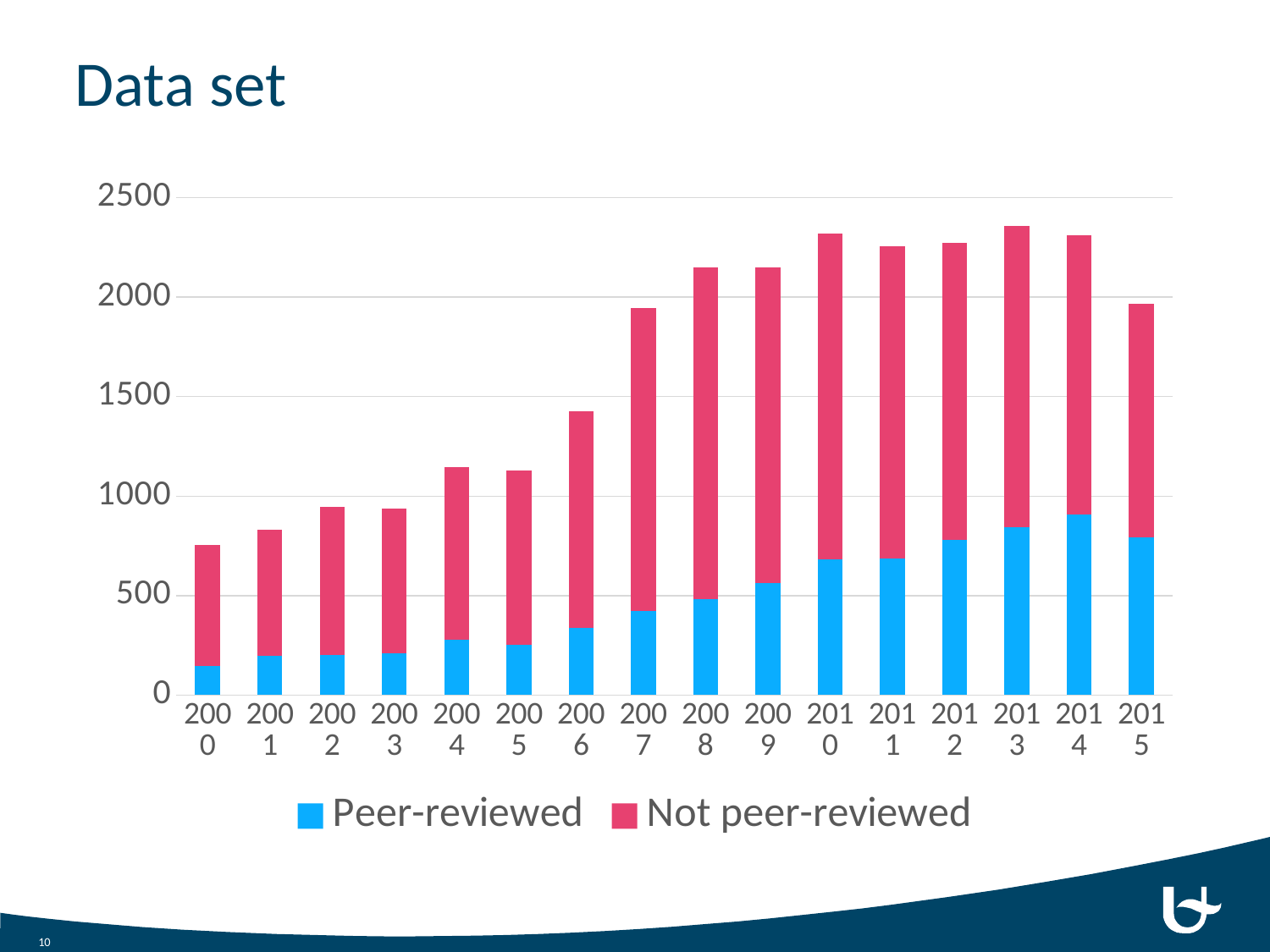
Is the total value for 2010 greater or less than 2000? greater Is the Peer-reviewed value for 2014 greater or less than 500? greater What is the title of the slide containing the chart? Data set Which series is shown in blue? Peer-reviewed Which year has the highest Peer-reviewed value? 2014 Which year has the lowest total value? 2000 Which year has the larger total value, 2006 or 2007? 2007 How many series does the legend list? 2 Is the total value for 2000 greater or less than 1000? less What kind of chart is shown on the slide? Stacked bar chart How many years are shown along the x axis? 16